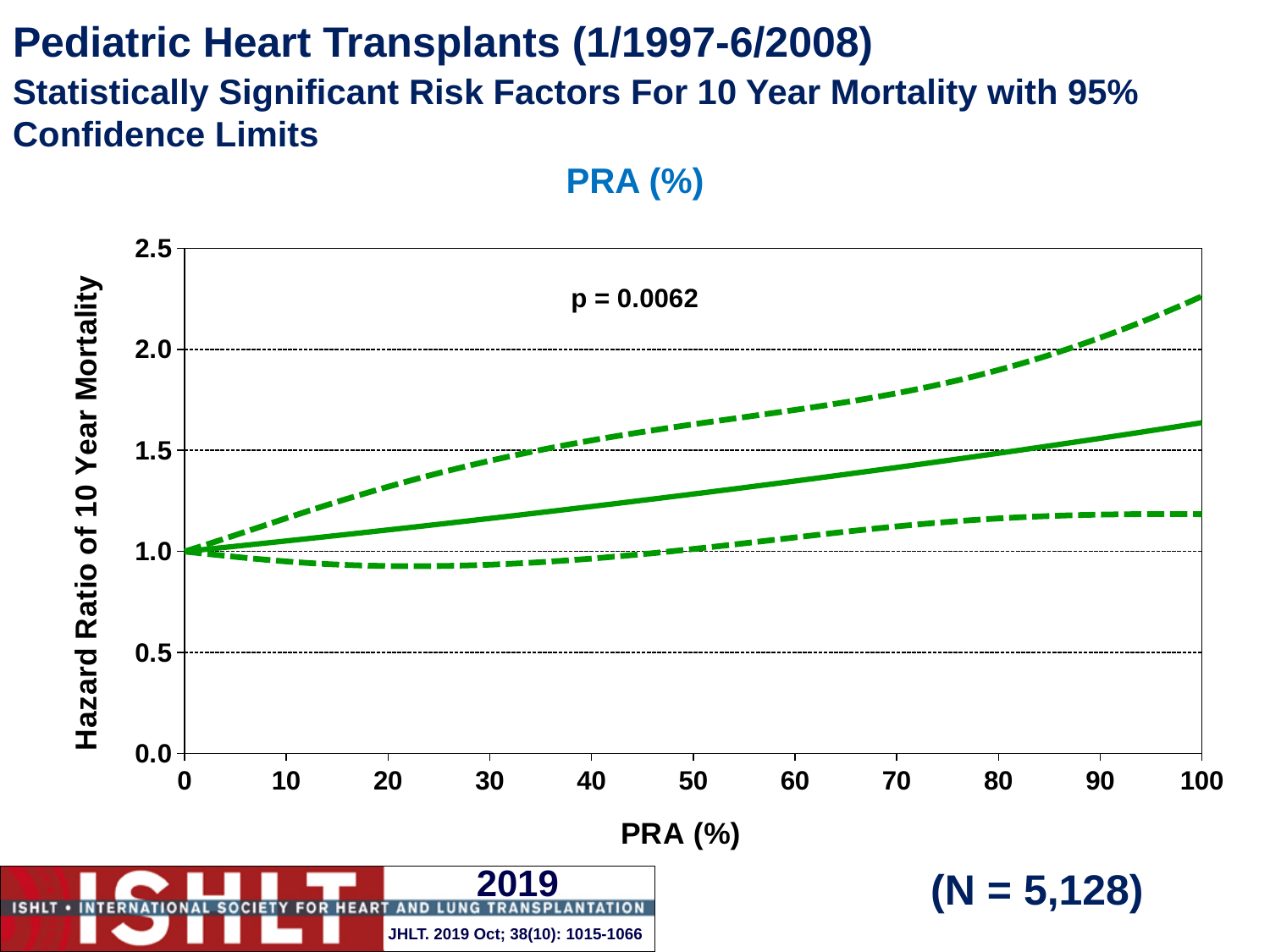
Does the solid hazard ratio line rise or fall as PRA (%) increases from 0 to 100? rise How many lines are plotted on the chart? 3 What p-value is printed on the chart? p = 0.0062 Is the lower dashed confidence limit at PRA 20% greater or less than 1.0? less At which PRA (%) value does the solid hazard ratio line reach its highest point? 100 Is the upper dashed confidence limit at PRA 100% greater or less than 2.0? greater Is the hazard ratio on the solid line at PRA 50% greater or less than 1.5? less What is the hazard ratio of 10 year mortality on the solid line at PRA 0%? 1.0 What kind of chart is shown on the slide? line chart What is the label of the y axis? Hazard Ratio of 10 Year Mortality